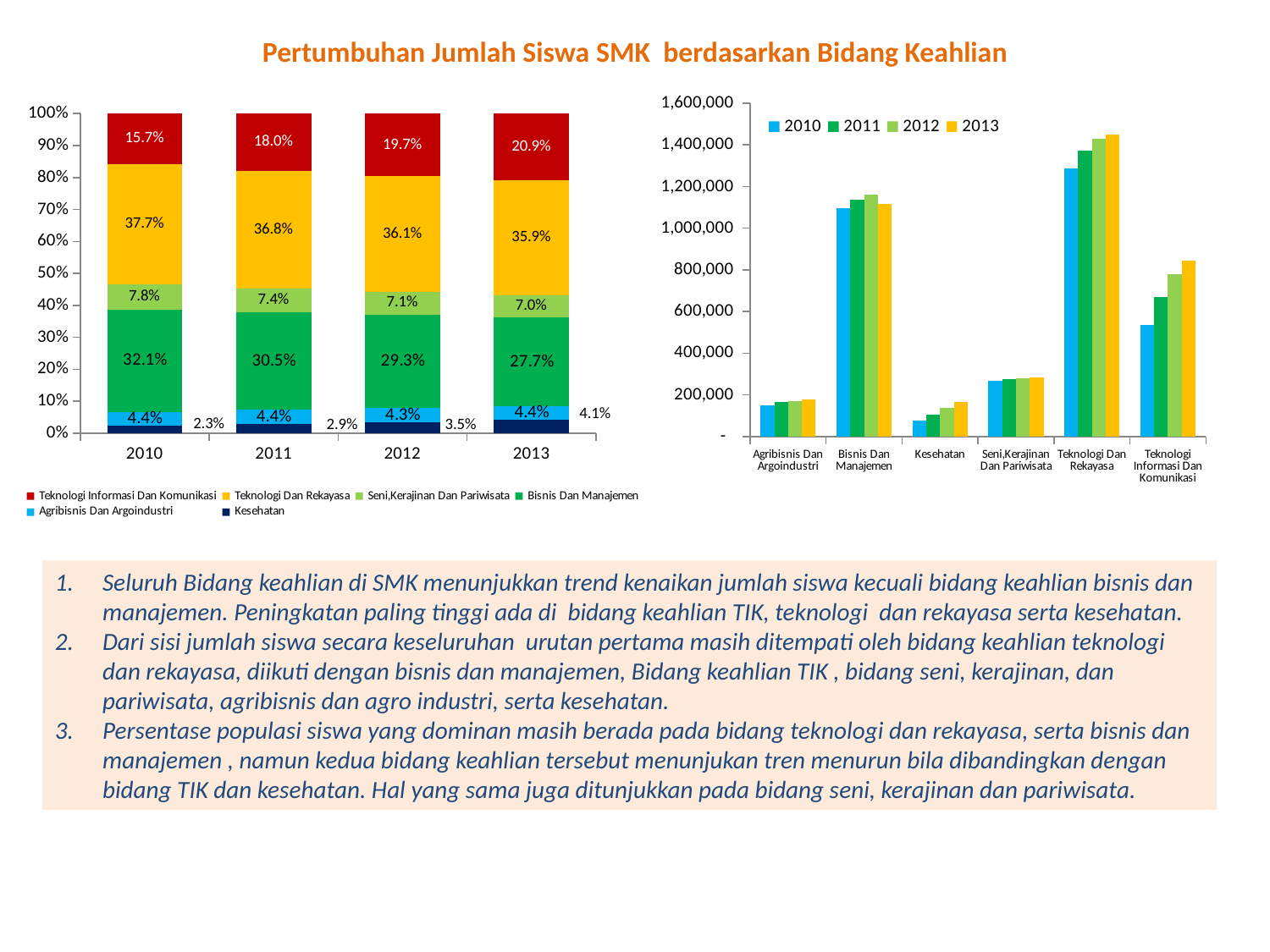
In the left stacked bar chart, does the percentage for Teknologi Informasi Dan Komunikasi rise or fall from 2010 to 2013? rise How many series does the legend of the right chart list? 4 In the left stacked bar chart, what percentage does Bisnis Dan Manajemen have in 2010? 32.1% In the left stacked bar chart, which year has the lowest percentage for Seni,Kerajinan Dan Pariwisata? 2013 What kind of chart is the chart on the right? bar chart In the right chart, is the value for Teknologi Dan Rekayasa in 2010 greater or less than 1,200,000? greater In the left stacked bar chart, what is the difference between the Bisnis Dan Manajemen percentage in 2010 and in 2013? 4.4% In the right chart, is the value for Kesehatan in 2010 greater or less than 200,000? less In the left stacked bar chart, which year has the highest percentage for Teknologi Dan Rekayasa? 2010 In the left stacked bar chart, what percentage does Teknologi Informasi Dan Komunikasi have in 2013? 20.9% How many categories are shown on the x axis of the right chart? 6 In the left stacked bar chart, what percentage does Kesehatan have in 2012? 3.5%